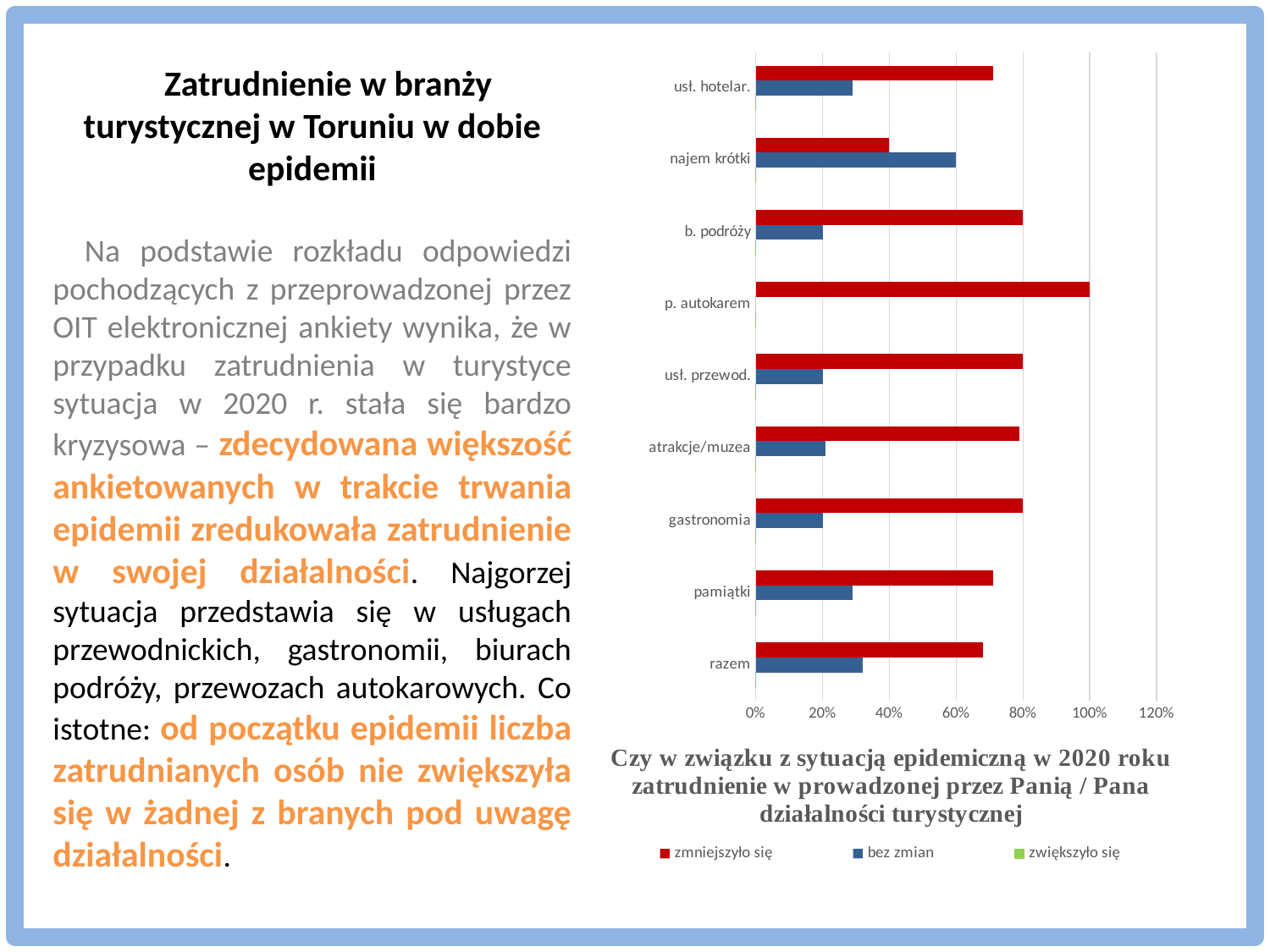
What kind of chart is shown on the slide? bar chart What are the three legend entries of the chart? zmniejszyło się, bez zmian, zwiększyło się What is the value for 'zmniejszyło się' in the category 'p. autokarem'? 100% Is the value for 'bez zmian' in 'razem' greater or less than 40%? less What is the value for 'bez zmian' in the category 'najem krótki'? 60% In the category 'najem krótki', which is larger: 'zmniejszyło się' or 'bez zmian'? bez zmian How many categories are shown on the chart's vertical axis? 9 How many series does the chart legend list? 3 Which category has the lowest value for 'zmniejszyło się'? najem krótki Which colour represents the series 'zmniejszyło się' in the chart? red Which category has the highest value for 'zmniejszyło się'? p. autokarem Is the value for 'zmniejszyło się' in 'usł. hotelar.' greater or less than 60%? greater